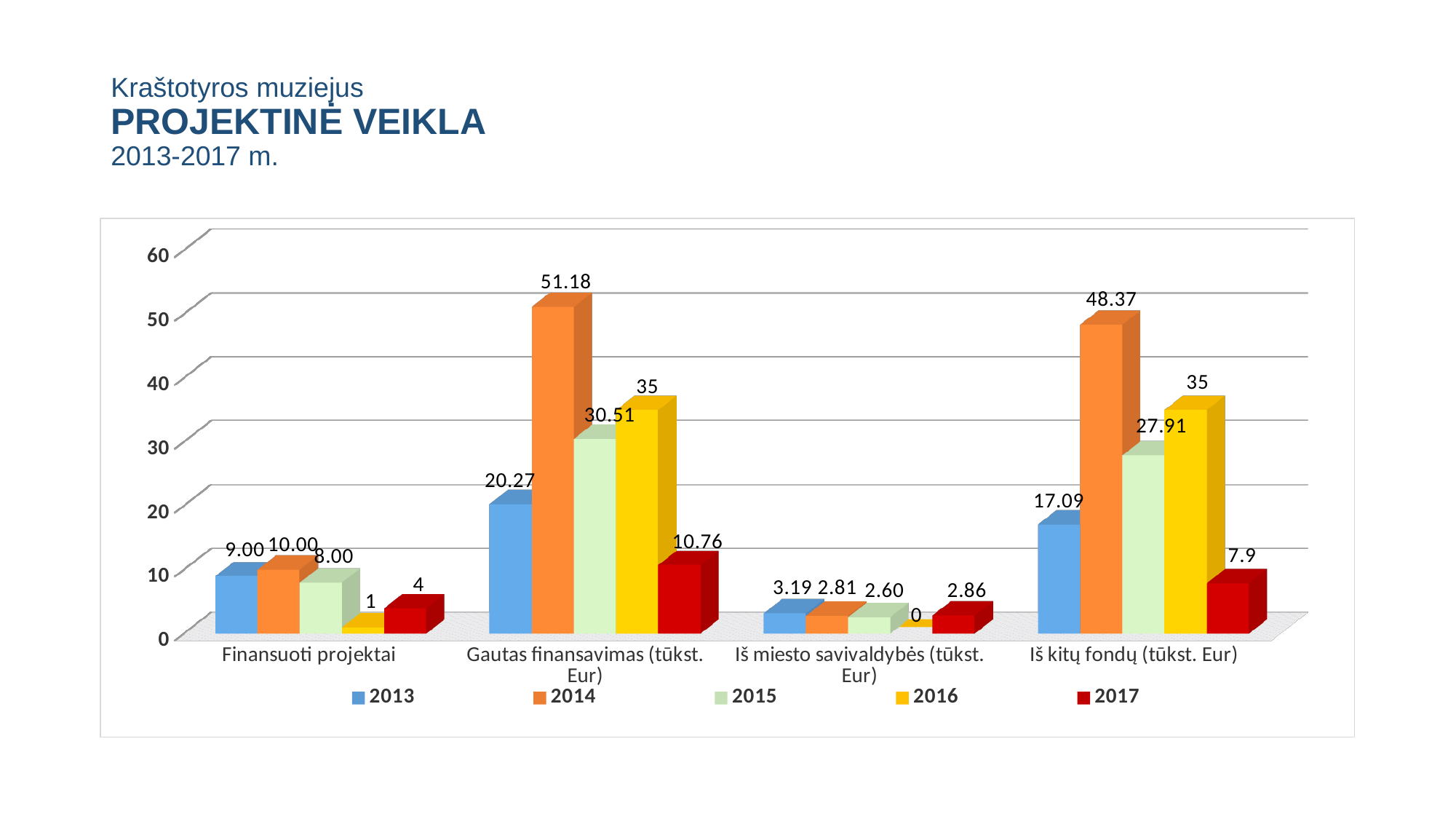
What is the value for 2014 in the category Gautas finansavimas (tūkst. Eur)? 51.18 What type of chart is shown on the slide? bar chart Which colour represents the 2017 series in the legend? dark red How many categories are shown on the x axis? 4 Which year has the lowest value in the category Gautas finansavimas (tūkst. Eur)? 2017 Which is larger in the category Iš miesto savivaldybės (tūkst. Eur): the value for 2013 or the value for 2017? 2013 What is the value for 2016 in the category Iš miesto savivaldybės (tūkst. Eur)? 0 Which year has the highest value in the category Finansuoti projektai? 2014 How many series does the legend list? 5 Is the value for 2015 in the category Gautas finansavimas (tūkst. Eur) greater or less than 40? less What is the value for 2017 in the category Iš kitų fondų (tūkst. Eur)? 7.9 What is the difference between the 2014 and 2013 values in the category Iš kitų fondų (tūkst. Eur)? 31.28